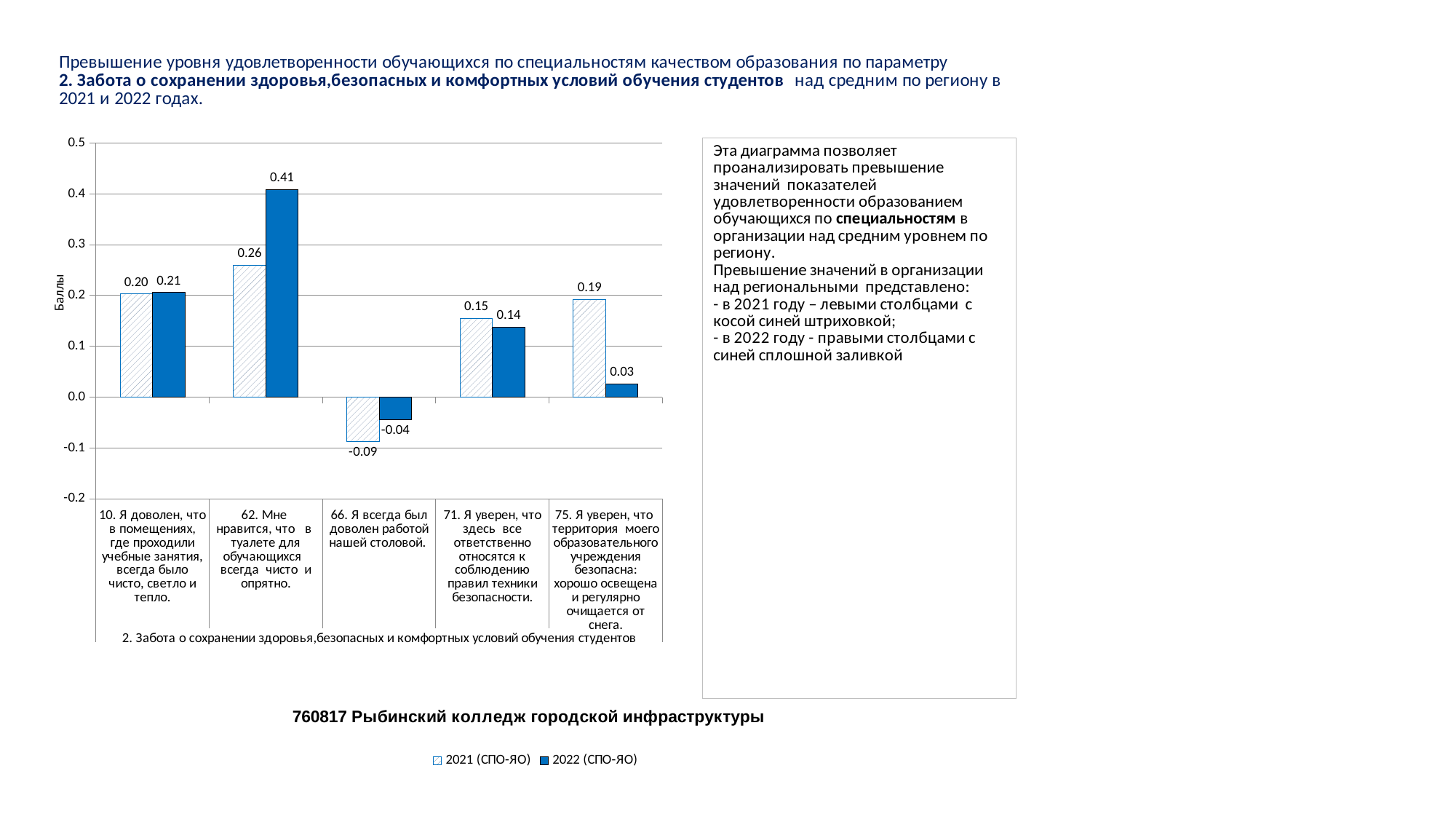
What is the 2022 (СПО-ЯО) value for question 62 ("Мне нравится, что в туалете для обучающихся всегда чисто и опрятно")? 0.41 How many questions (categories) are shown on the x axis? 5 For question 66, which is larger: the 2021 value or the 2022 value? 2022 What is the 2022 (СПО-ЯО) value for question 75 ("Я уверен, что территория моего образовательного учреждения безопасна")? 0.03 What is the label of the y axis? Баллы How many series does the legend list? 2 Which question has the highest 2022 (СПО-ЯО) value? 62. Мне нравится, что в туалете для обучающихся всегда чисто и опрятно. What is the difference between the 2021 and 2022 values for question 75? 0.16 What is the difference between the 2022 and 2021 values for question 62? 0.15 What is the 2021 (СПО-ЯО) value for question 66 ("Я всегда был доволен работой нашей столовой")? -0.09 Which question has the lowest 2021 (СПО-ЯО) value? 66. Я всегда был доволен работой нашей столовой. What kind of chart is shown on the slide? Bar chart